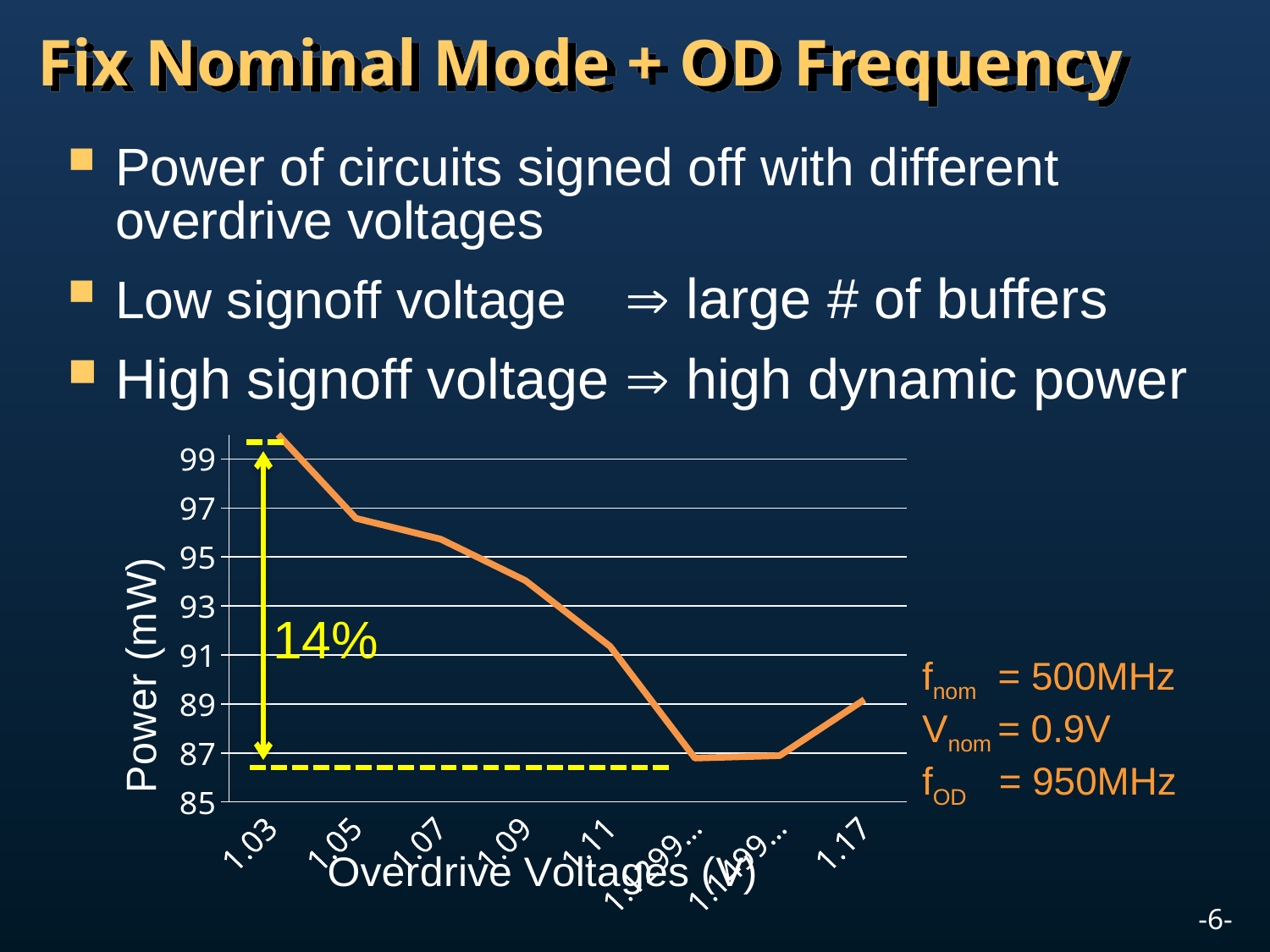
How many data points are plotted on the line? 8 Is the power at overdrive voltage 1.09 greater or less than 93? greater Which has higher power, overdrive voltage 1.07 or 1.17? 1.07 Is the power at overdrive voltage 1.11 greater or less than 93? less Which overdrive voltage has the highest power? 1.03 What kind of chart is shown on the slide? line chart Is the power at overdrive voltage 1.05 greater or less than 97? less Does the power rise or fall as the overdrive voltage increases from 1.03 to 1.11? fall What percentage is annotated next to the vertical arrow on the chart? 14% What is the y-axis title of the chart? Power (mW)